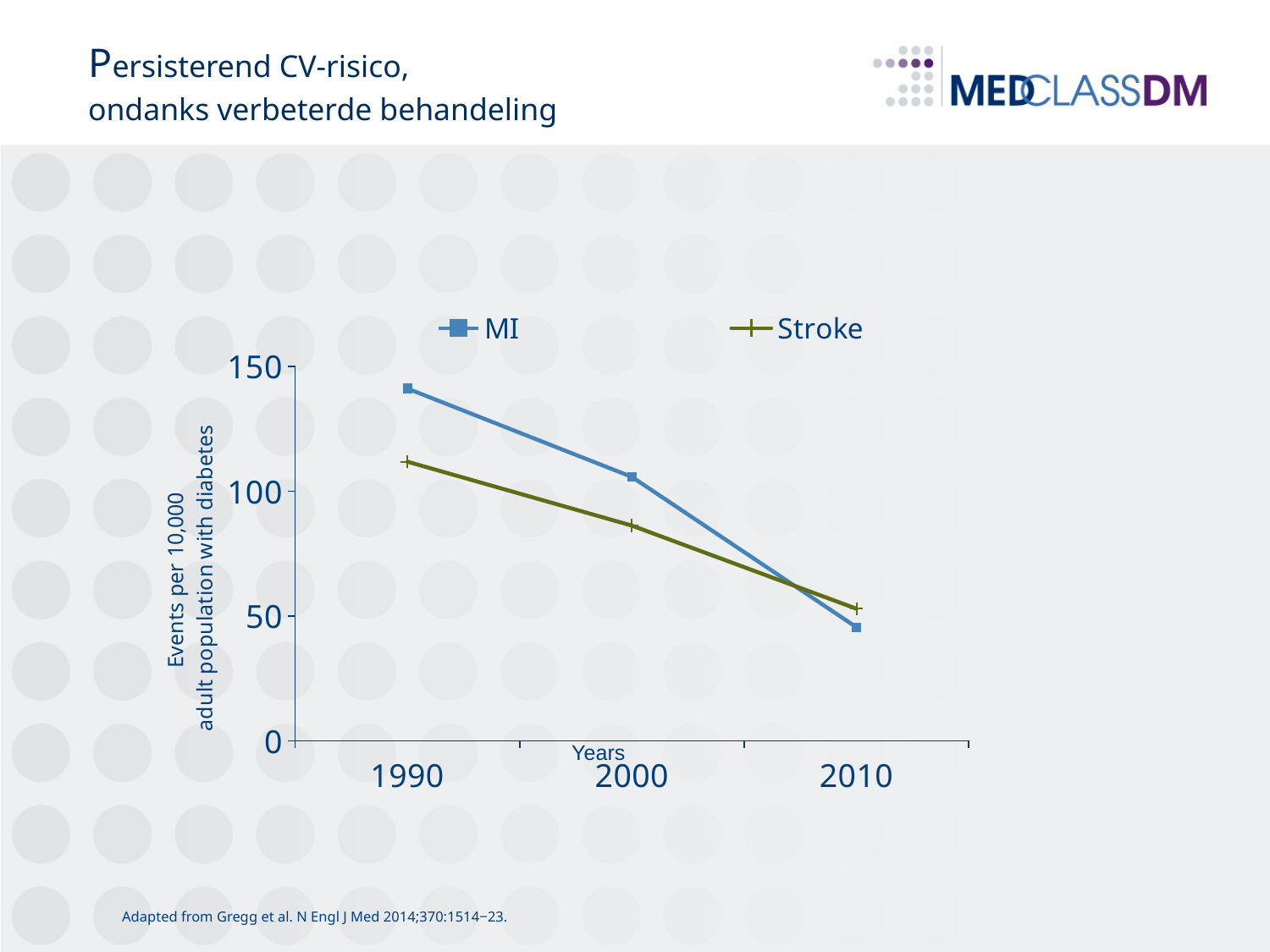
What is the label of the y axis? Events per 10,000 adult population with diabetes In which year is the MI value highest? 1990 Does the Stroke series rise or fall from 1990 to 2010? fall How many years are plotted along the x axis? 3 Is the value for MI in 2010 greater or less than 50? less Is the value for Stroke in 1990 greater or less than 100? greater Does the MI series rise or fall from 1990 to 2010? fall Is the value for MI in 1990 greater or less than 100? greater How many series does the legend list? 2 What kind of chart is shown on the slide? line chart In 1990, which series has the higher value, MI or Stroke? MI